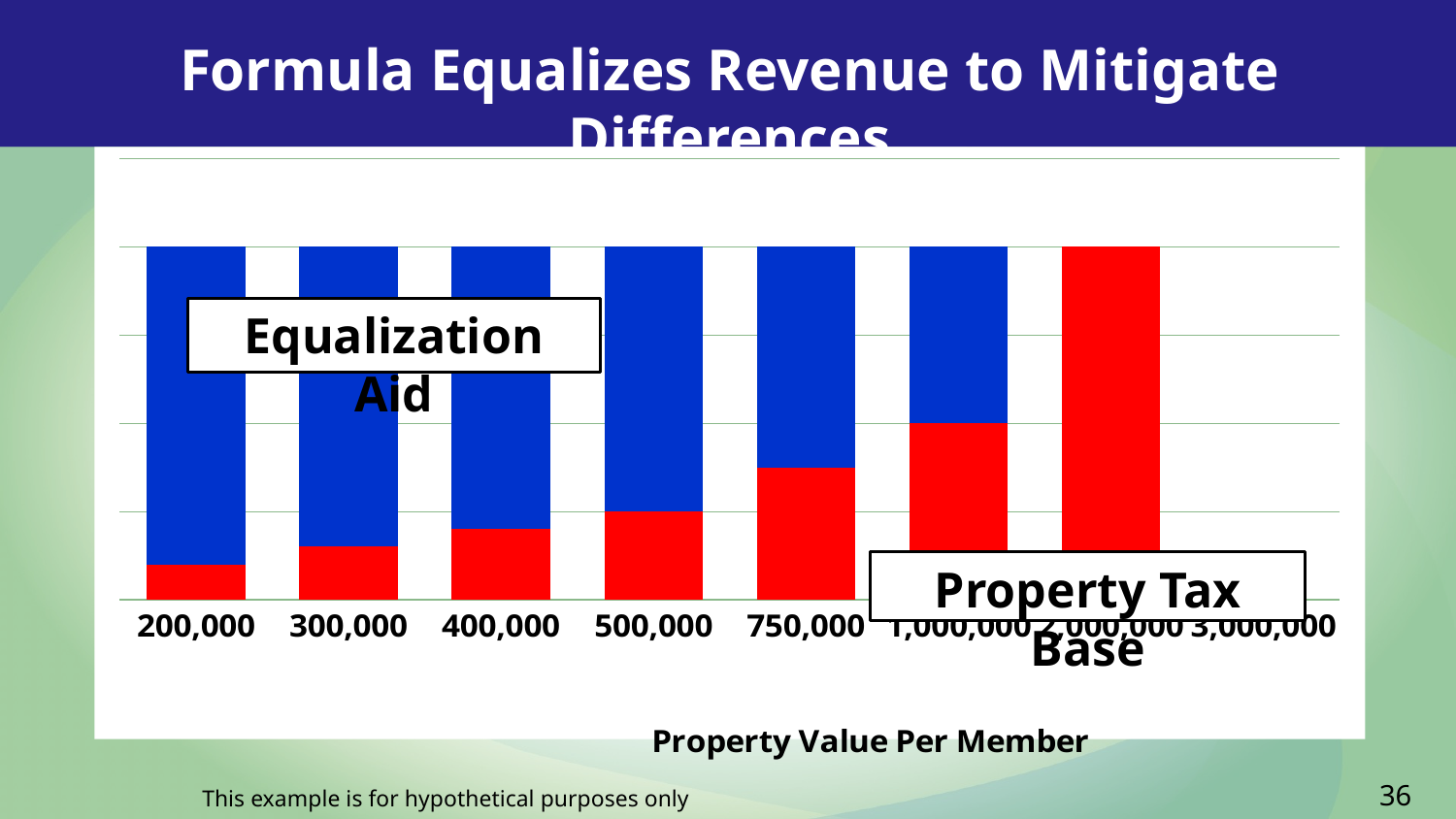
Which category has the smallest Property Tax Base portion? 200,000 Which category receives no Equalization Aid? 2,000,000 Which category has the largest Property Tax Base portion? 2,000,000 What are the two series labelled in the chart? Equalization Aid and Property Tax Base How many property value categories are shown along the x axis? 8 What is the title of the x axis? Property Value Per Member What kind of chart is shown on the slide? Stacked bar chart Does the Property Tax Base portion rise or fall as property value per member increases along the x axis? Rise How many series does the chart show? 2 Is the Equalization Aid portion larger for 400,000 or for 1,000,000? 400,000 Which category has the largest Equalization Aid portion? 200,000 Is the Property Tax Base portion larger for 750,000 or for 300,000? 750,000